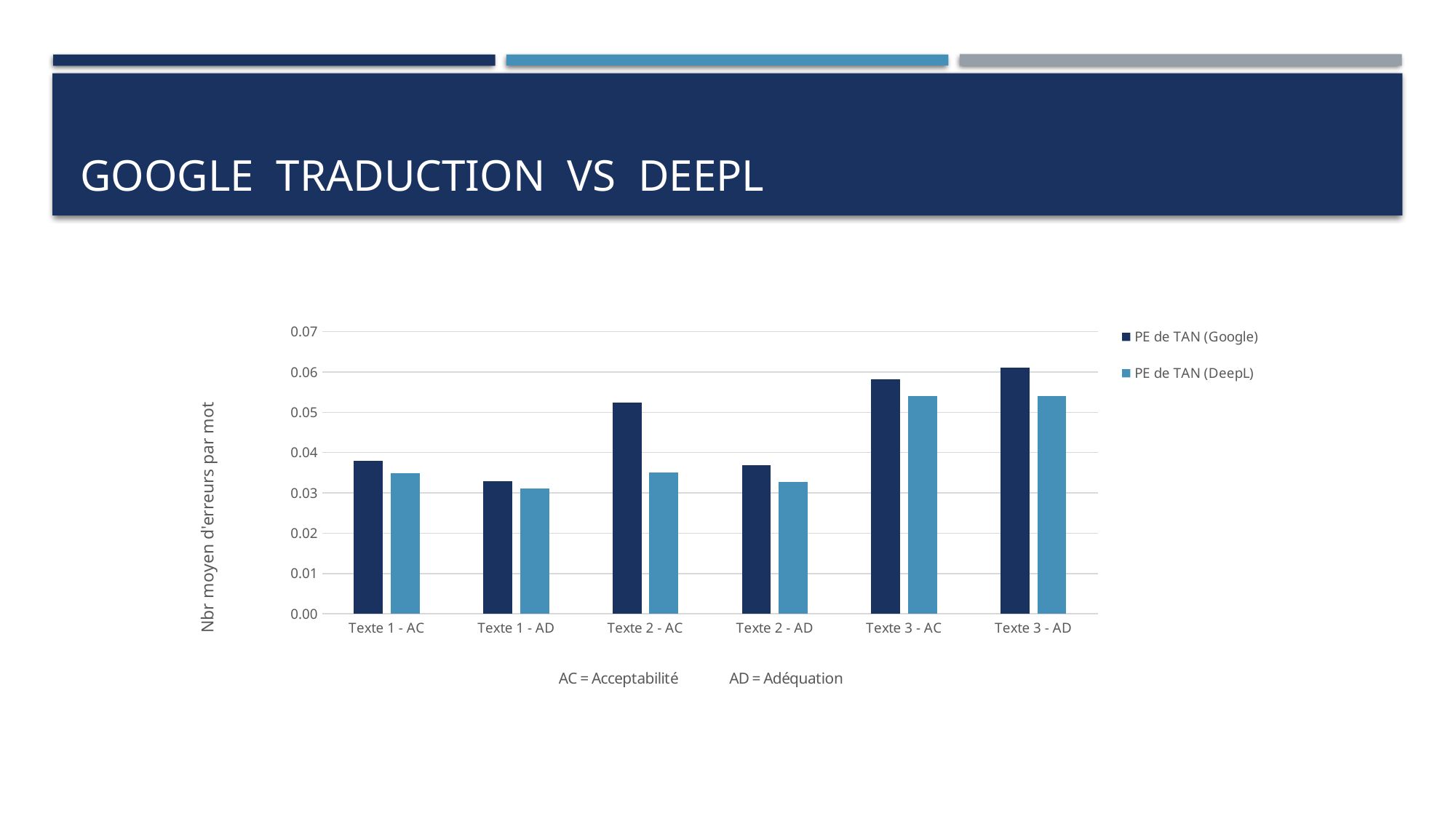
What is the title of the vertical axis? Nbr moyen d'erreurs par mot Is the value for PE de TAN (Google) at Texte 1 - AD greater or less than 0.04? less For Texte 2 - AC, which series has the larger value, PE de TAN (Google) or PE de TAN (DeepL)? PE de TAN (Google) For Texte 3 - AD, which series has the larger value, PE de TAN (Google) or PE de TAN (DeepL)? PE de TAN (Google) Is the value for PE de TAN (DeepL) at Texte 3 - AC greater or less than 0.05? greater Which category has the highest value for PE de TAN (Google)? Texte 3 - AD How many categories are shown on the x axis? 6 Is the value for PE de TAN (DeepL) at Texte 1 - AC greater or less than 0.04? less Which category has the lowest value for PE de TAN (Google)? Texte 1 - AD What kind of chart is shown on the slide? bar chart How many series does the legend list? 2